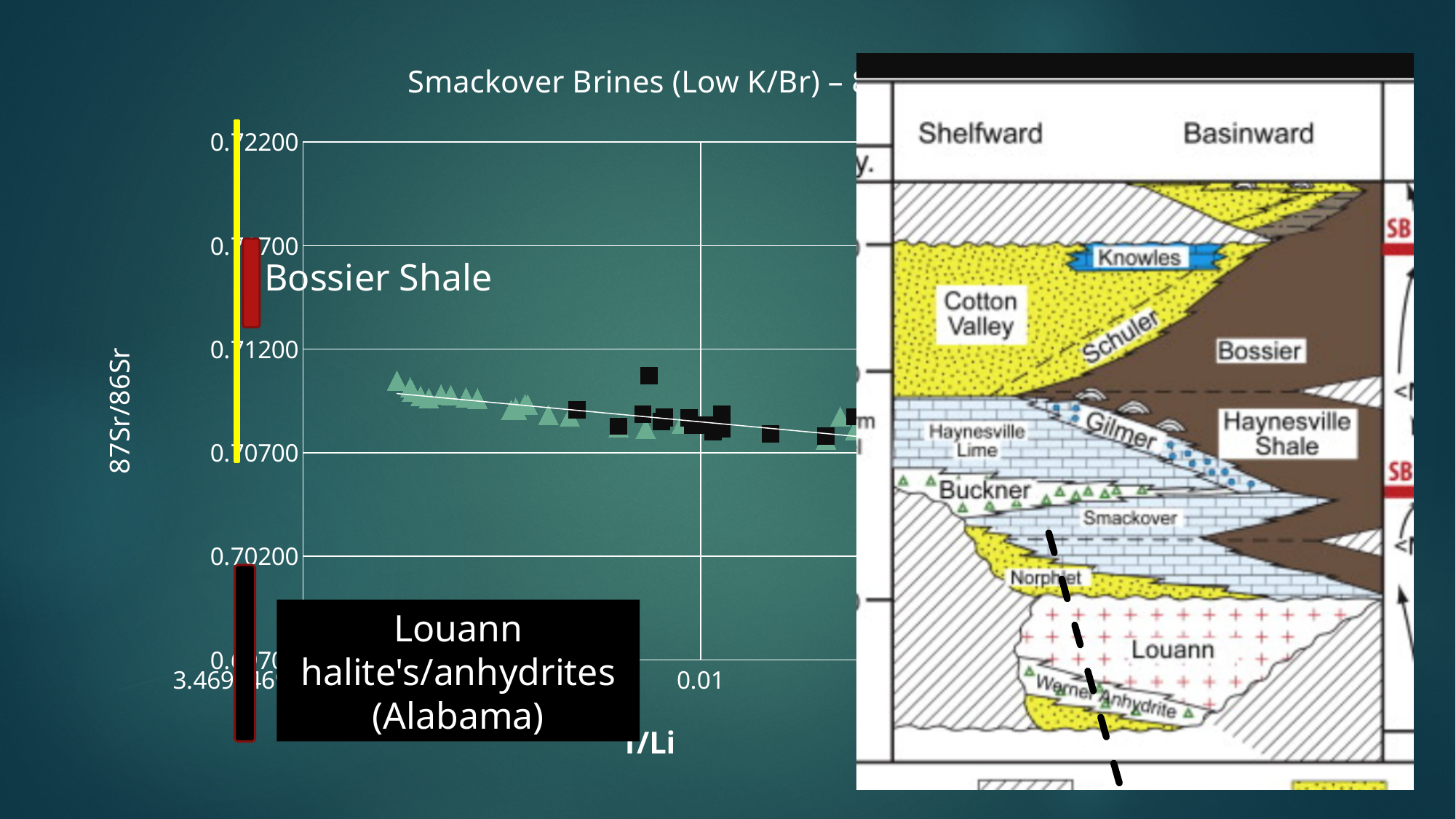
How many different marker shapes are plotted on the scatter chart? 2 Are the plotted 87Sr/86Sr values greater or less than 0.71200? less What is the label on the y axis of the scatter chart? 87Sr/86Sr What kind of chart is shown on the left of the slide? scatter chart Are the plotted 87Sr/86Sr values greater or less than 0.70700? greater Do the plotted 87Sr/86Sr values rise or fall as the x-axis value increases? fall